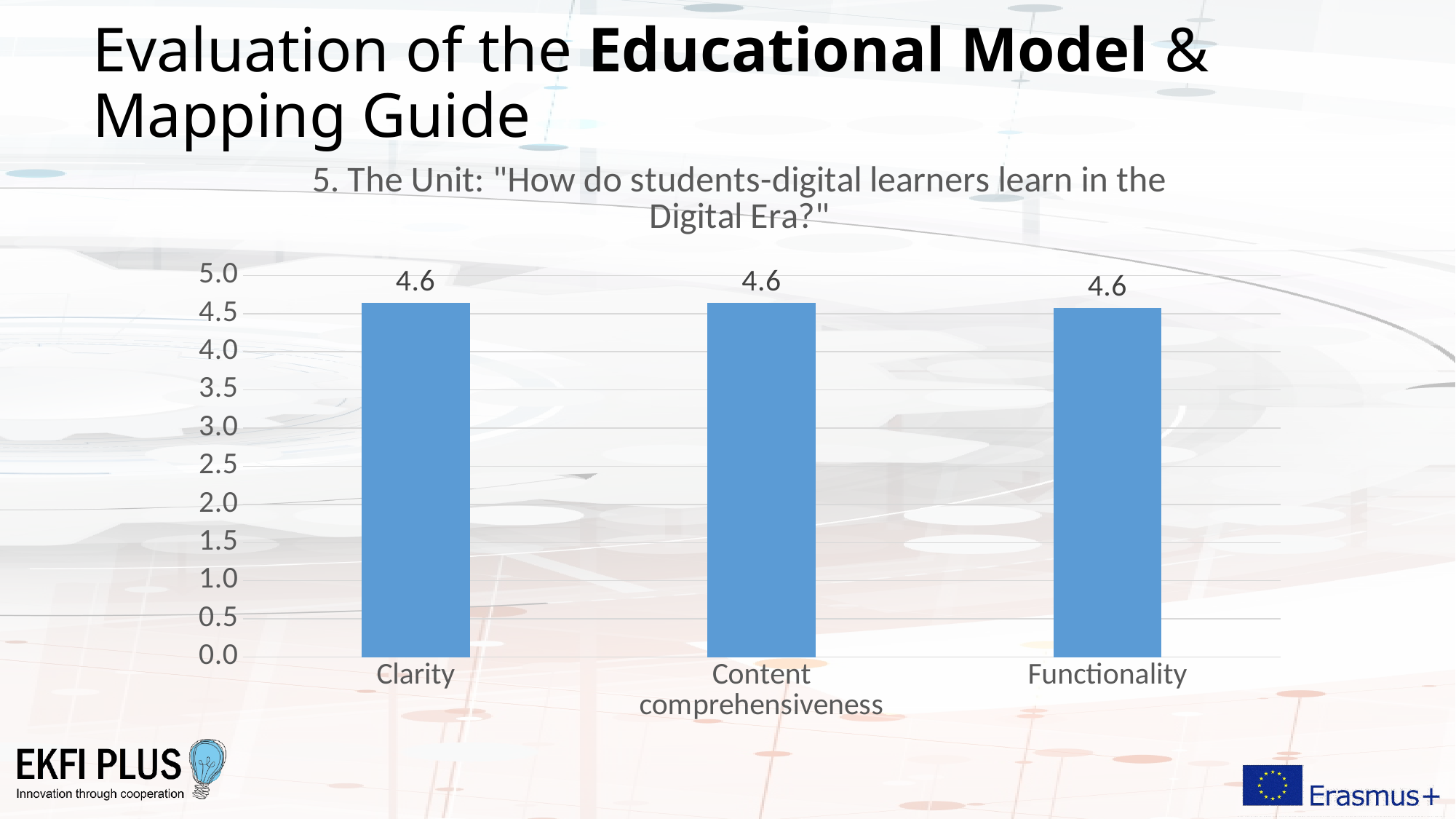
What is the difference between the values for Clarity and Content comprehensiveness? 0.0 How many categories are shown on the x axis of the chart? 3 What is the value for Clarity? 4.6 What is the maximum value shown on the y axis of the chart? 5.0 What kind of chart is shown on the slide? Bar chart What is the title of the chart? 5. The Unit: "How do students-digital learners learn in the Digital Era?" Is the value for Clarity greater or less than 5.0? less Is the value for Functionality greater or less than 4.0? greater What is the value for Content comprehensiveness? 4.6 Do the values rise, fall, or stay the same across the categories from left to right? Stay the same What is the value for Functionality? 4.6